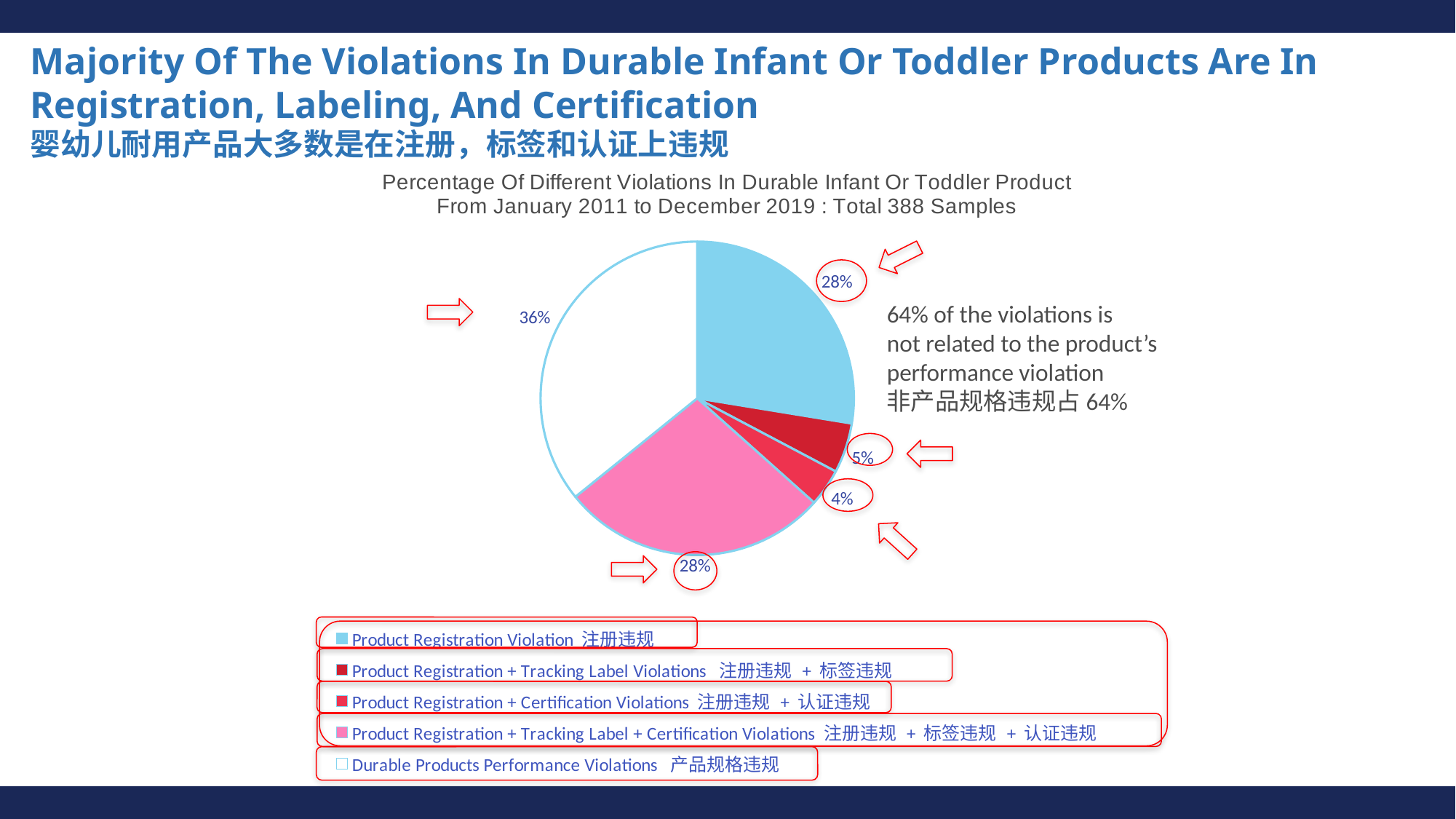
What percentage of violations are Product Registration + Tracking Label Violations? 5% How many samples in total does the chart title say were included? 388 What percentage of violations are Product Registration Violation only? 28% What is the difference in percentage points between Durable Products Performance Violations and Product Registration Violation? 8 How many categories does the pie chart have? 5 What percentage of violations are Product Registration + Certification Violations? 4% Which is larger: the share for Product Registration + Tracking Label Violations or Product Registration + Certification Violations? Product Registration + Tracking Label Violations Which category has the smallest share of the pie? Product Registration + Certification Violations What kind of chart is shown on the slide? Pie chart What percentage of violations are Product Registration + Tracking Label + Certification Violations? 28% Which category has the largest share of the pie? Durable Products Performance Violations What percentage of violations are Durable Products Performance Violations? 36%